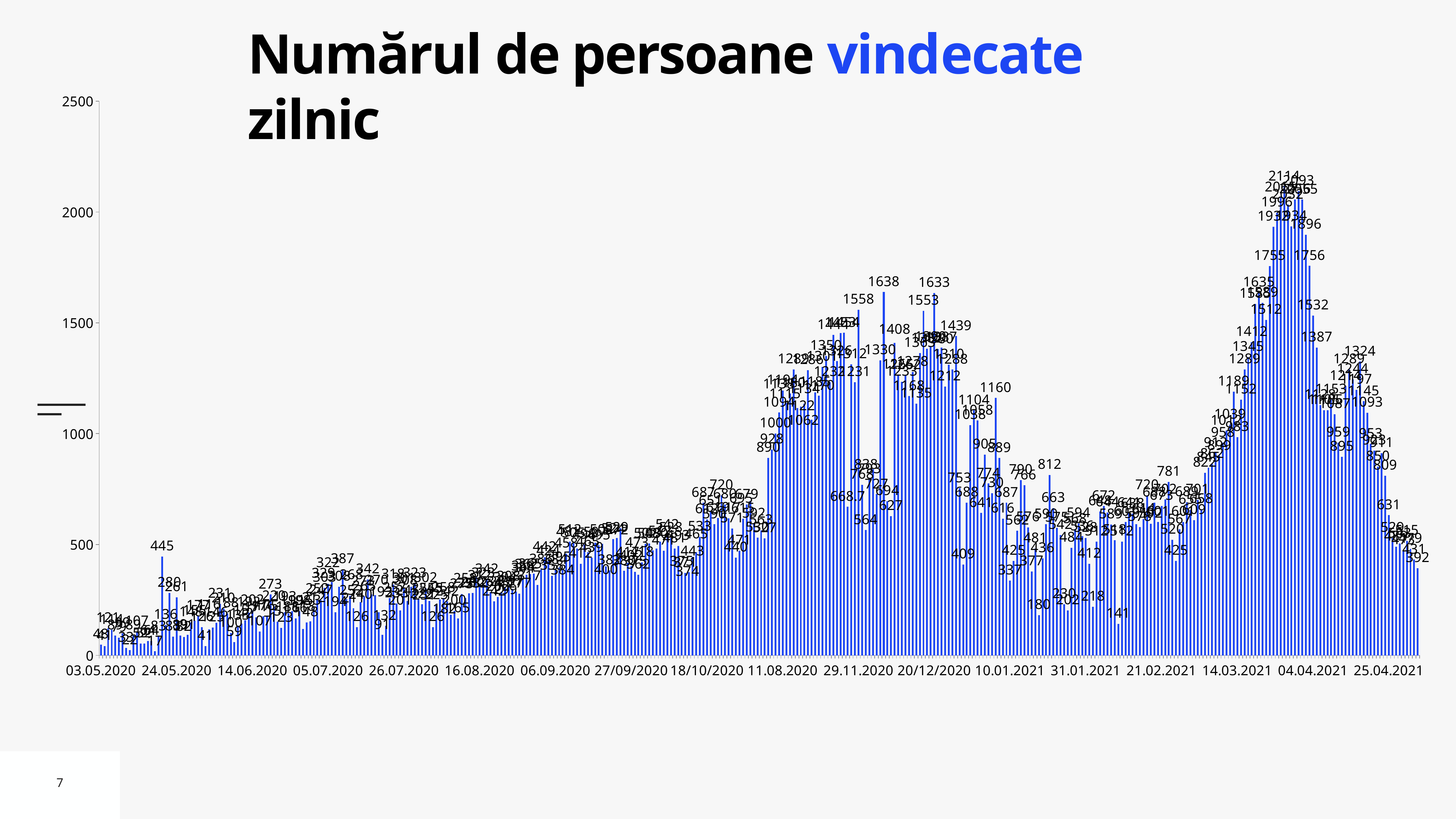
What is the highest value labelled on the chart? 2114 Which peak is higher: the one around 04.04.2021 or the one around 29.11.2020? the one around 04.04.2021 What is the difference between the highest labelled value (2114) and the highest value of the late-November 2020 peak (1638)? 476 What is the highest tick value shown on the vertical axis? 2500 Is the value of the first bar at 03.05.2020 greater or less than 500? less What kind of chart is shown on the slide? bar chart What is the title of the chart? Numărul de persoane vindecate zilnic What is the value of the last bar on the right of the chart? 392 What is the value of the highest bar between 10.01.2021 and 31.01.2021? 812 Do the values rise or fall from 04.04.2021 to 25.04.2021? fall What is the value of the tall spike just before 24.05.2020? 445